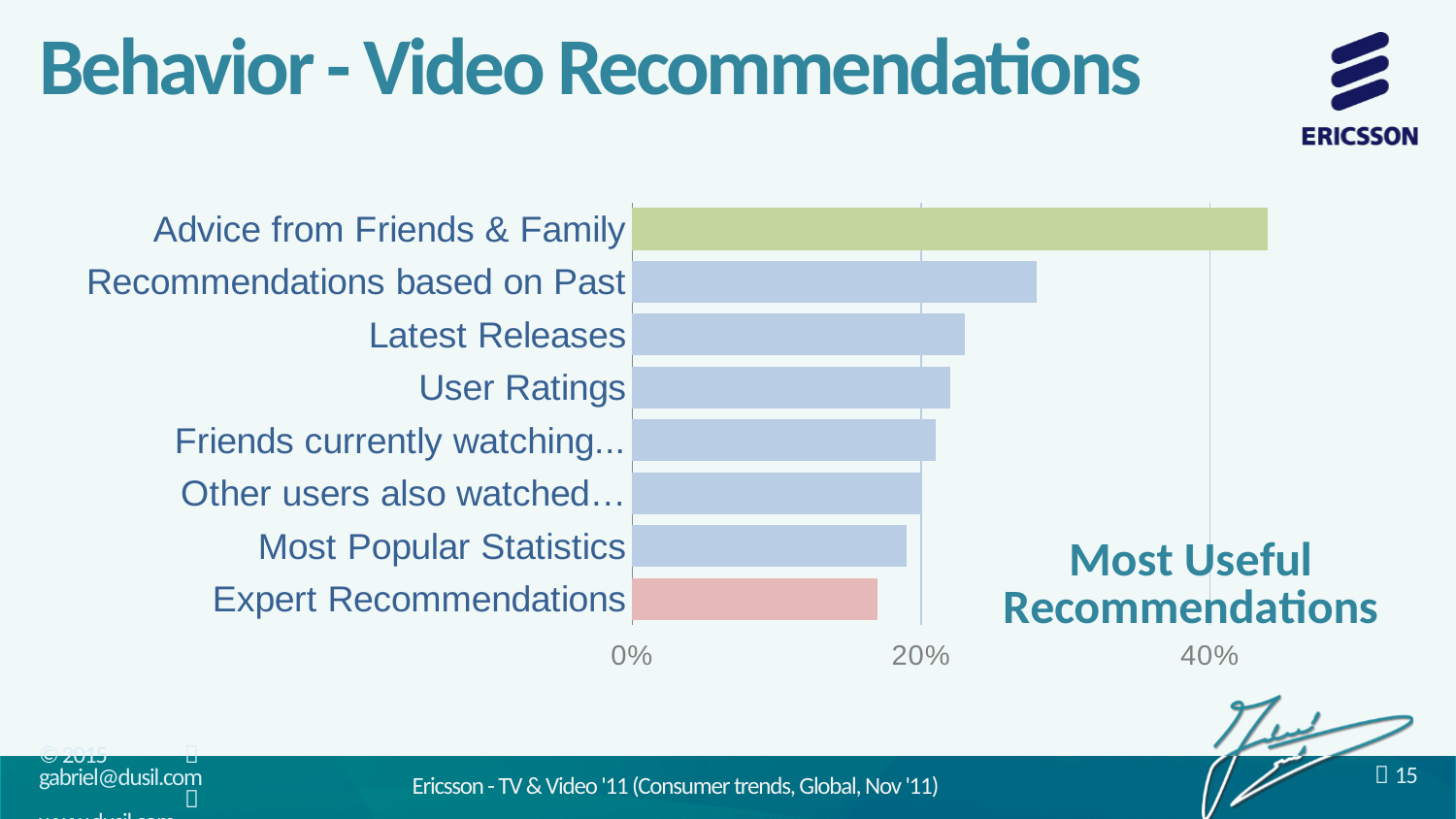
What is the title shown on the chart? Most Useful Recommendations Is the value for Latest Releases greater or less than 20%? greater How many categories are plotted in the chart? 8 Is the value for Advice from Friends & Family greater or less than 40%? greater Is the value for Recommendations based on Past greater or less than 20%? greater What colour is the bar for Advice from Friends & Family? green Which category has the highest value in the chart? Advice from Friends & Family What kind of chart is shown on the slide? bar chart Which category has the lowest value in the chart? Expert Recommendations Which is larger, the value for Advice from Friends & Family or the value for Recommendations based on Past? Advice from Friends & Family Which is larger, the value for Latest Releases or the value for Expert Recommendations? Latest Releases